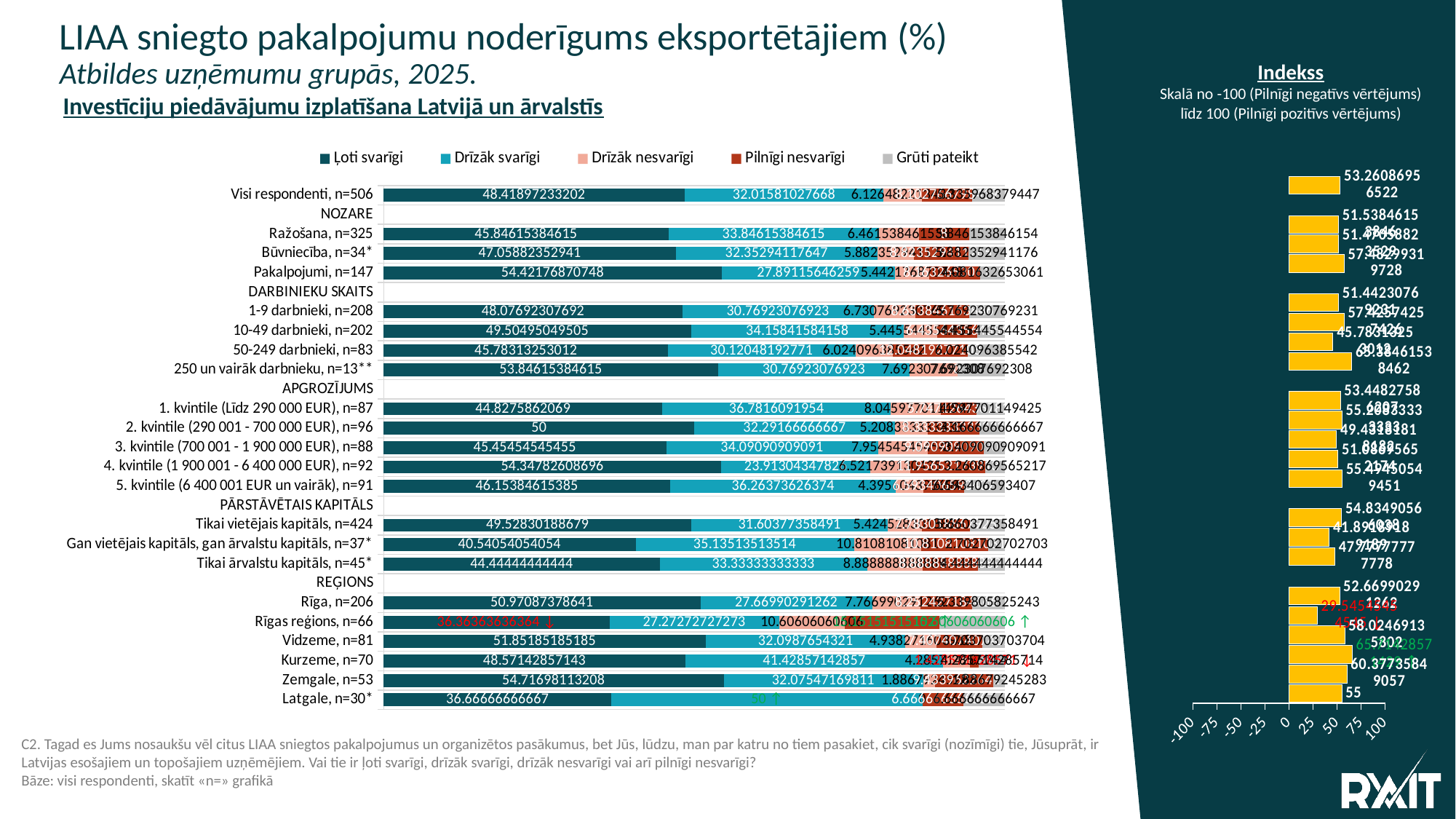
In the stacked bar chart, which is larger for 'Ļoti svarīgi': 'Pakalpojumi, n=147' or 'Ražošana, n=325'? Pakalpojumi, n=147 In the stacked bar chart, what is the 'Ļoti svarīgi' value for 'Visi respondenti, n=506'? 48.41897233202 In the stacked bar chart, what is the 'Drīzāk svarīgi' value for 'Kurzeme, n=70'? 41.42857142857 In the stacked bar chart, what is the difference between the 'Ļoti svarīgi' and 'Drīzāk svarīgi' values for 'Visi respondenti, n=506'? 16.40316205534 In the Indekss chart on the right, what is the index value for 'Visi respondenti, n=506'? 53.26086956522 In the Indekss chart on the right, is the value for 'Visi respondenti, n=506' greater or less than 50? greater In the stacked bar chart, what is the 'Drīzāk svarīgi' value for 'Latgale, n=30*'? 50 In the stacked bar chart, which region has the highest 'Drīzāk svarīgi' value? Latgale, n=30* What kind of chart is the main chart on the left of the slide? Stacked bar chart In the stacked bar chart, what is the 'Ļoti svarīgi' value for 'Pakalpojumi, n=147'? 54.42176870748 How many series does the legend of the stacked bar chart list? 5 In the stacked bar chart, what is the 'Ļoti svarīgi' value for '2. kvintile (290 001 - 700 000 EUR), n=96'? 50